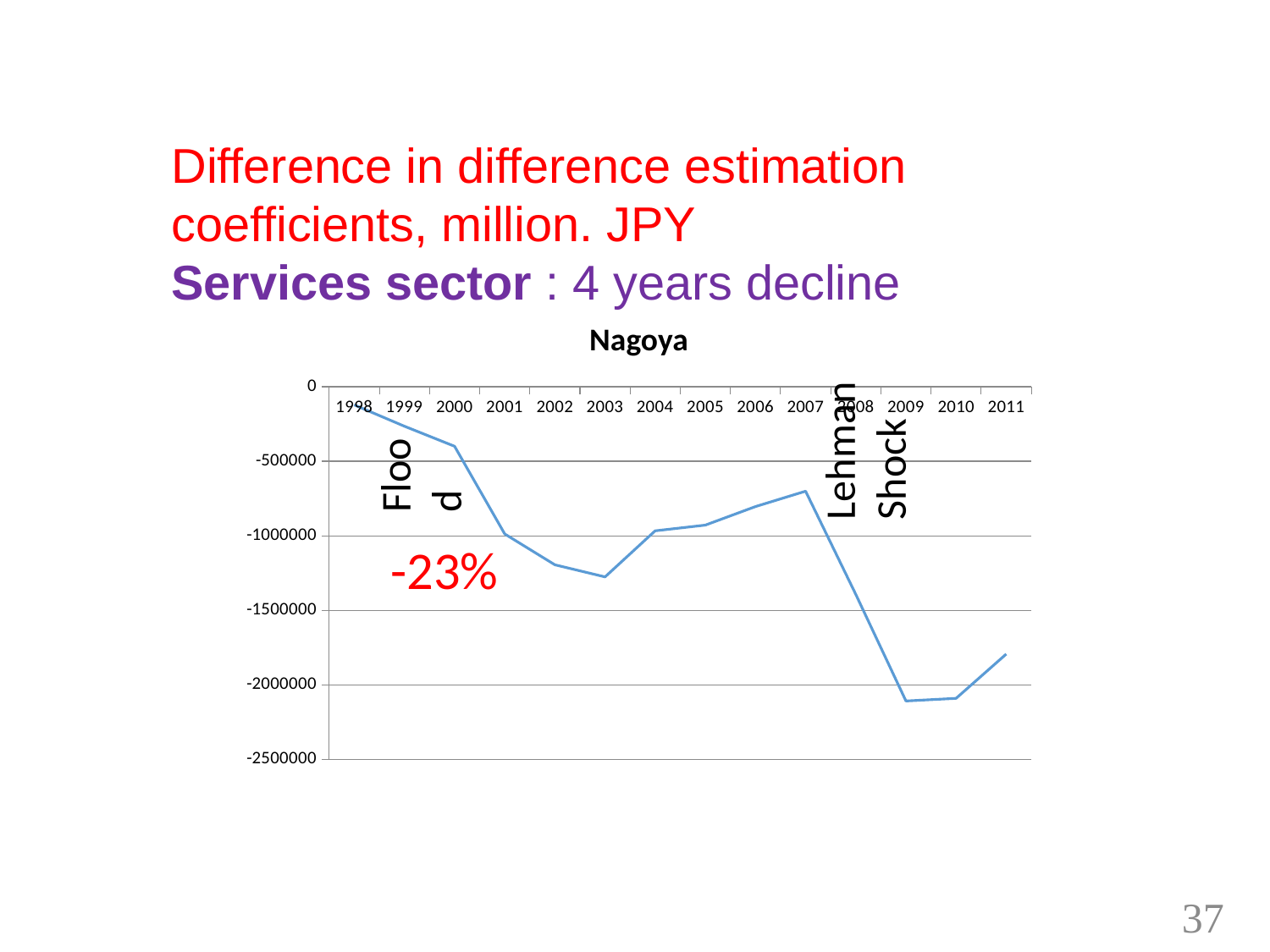
Is the value for 2009 greater or less than -2000000? less Is the value for 2003 greater or less than -1000000? less Which is larger, the value for 1998 or the value for 2009? 1998 Which year has the highest value on the chart? 1998 Is the value for 2000 greater or less than -500000? greater What percentage annotation is written in red on the chart? -23% What is the title of the chart? Nagoya What kind of chart is shown on the slide? line chart Do the values rise or fall from 2007 to 2009? fall How many years are plotted on the x axis of the chart? 14